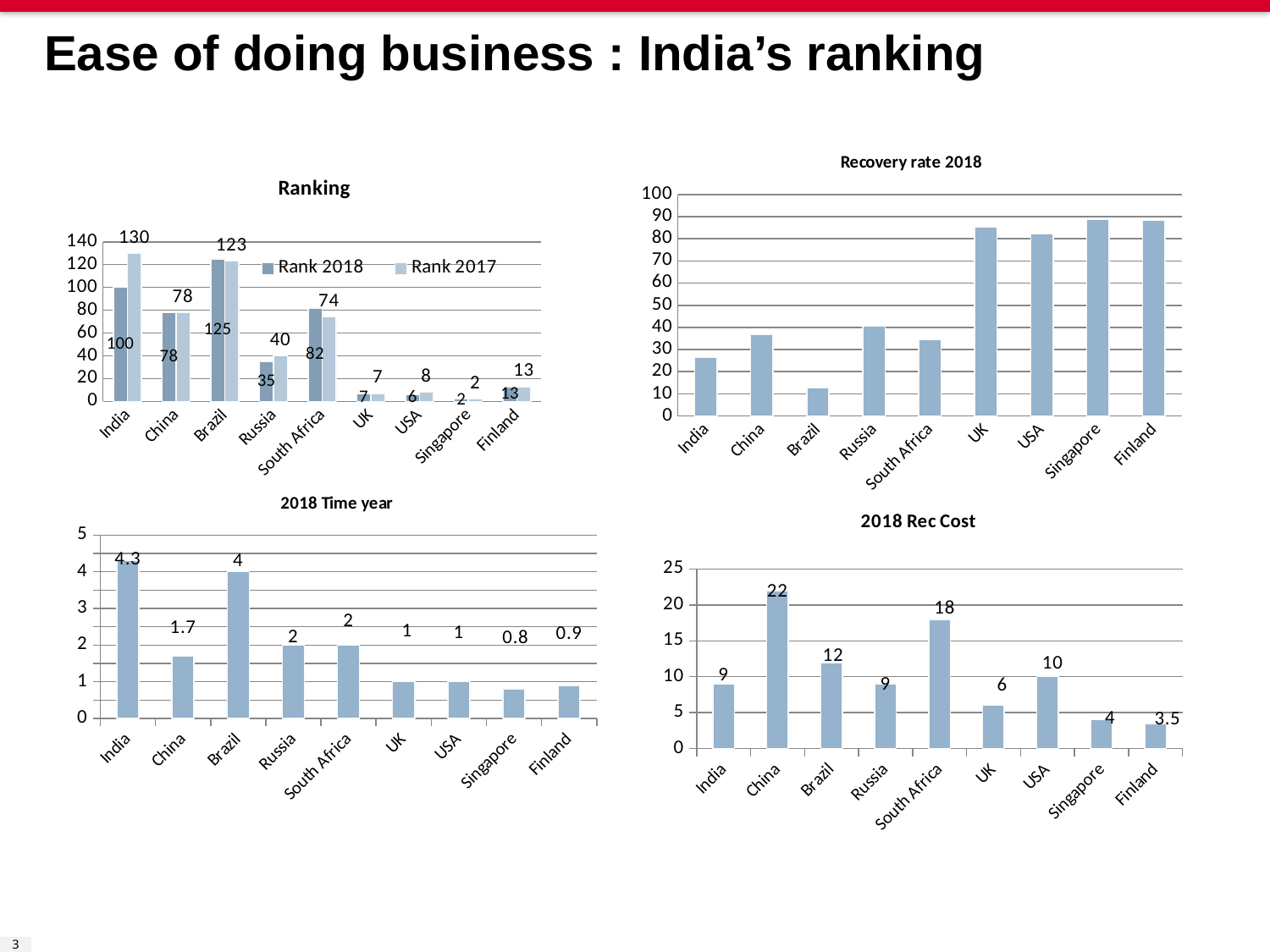
In the 2018 Time year chart, which country has the highest value? India In the 2018 Time year chart, what is the value for Singapore? 0.8 In the Ranking chart, what is India's Rank 2017 value? 130 In the Ranking chart, what is Brazil's Rank 2018 value? 125 In the 2018 Rec Cost chart, which country has the highest value? China In the Ranking chart, how many series does the legend list? 2 In the Recovery rate 2018 chart, is the value for UK greater or less than 80? greater How many countries are shown on the x axis of the 2018 Rec Cost chart? 9 In the 2018 Rec Cost chart, what is the difference between the values for South Africa and UK? 12 In the Recovery rate 2018 chart, is the value for Brazil greater or less than 20? less In the Recovery rate 2018 chart, which country has the lowest value? Brazil In the Ranking chart, what is the difference between India's Rank 2017 and Rank 2018 values? 30